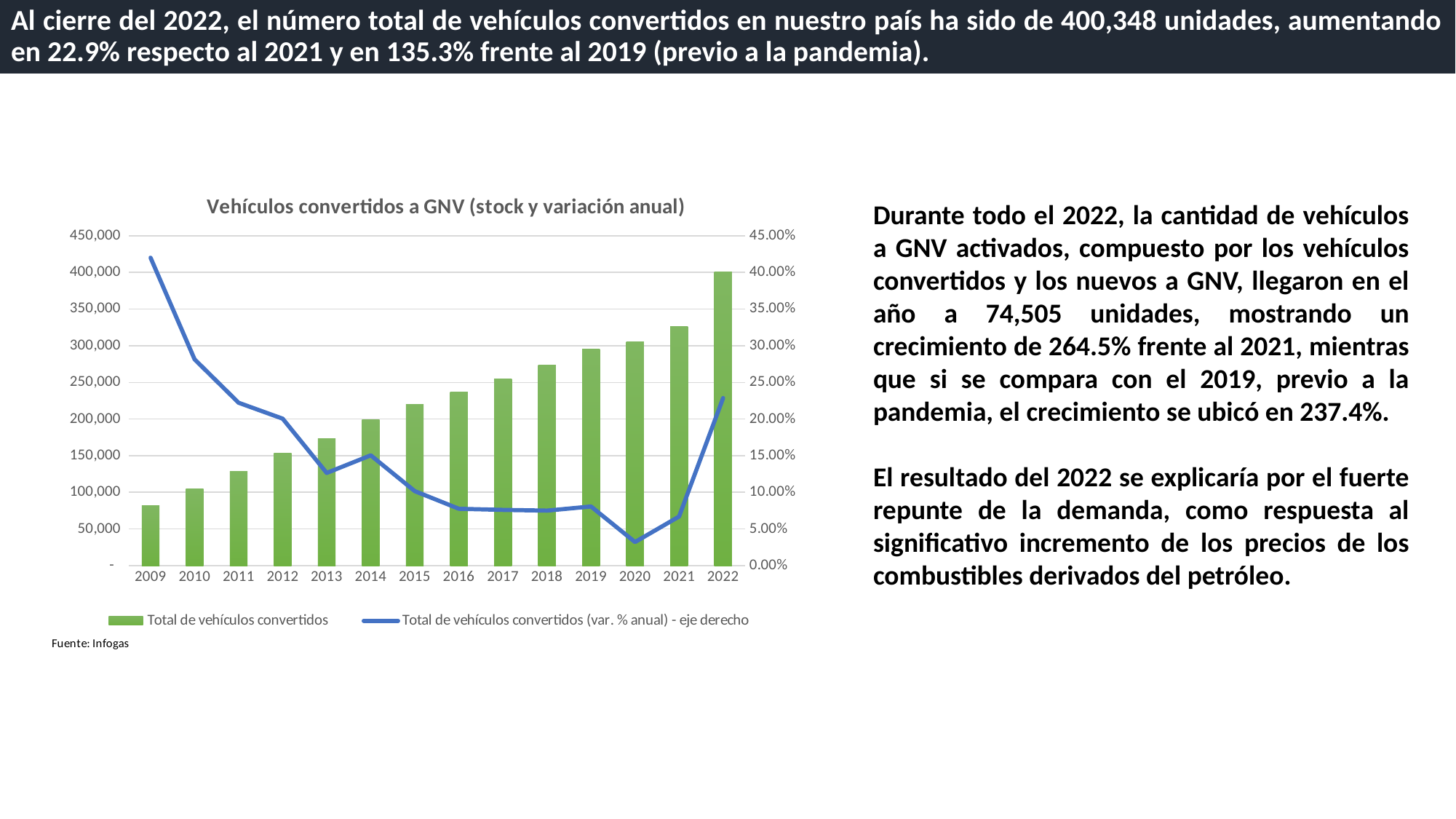
Is the bar for Total de vehículos convertidos in 2021 greater or less than 300,000? greater Is the annual variation (var. % anual) for 2020 greater or less than 5.00%? less Which year has the lowest bar for Total de vehículos convertidos? 2009 Do the bars for Total de vehículos convertidos rise or fall from 2009 to 2022? rise Which year has a larger bar for Total de vehículos convertidos, 2013 or 2018? 2018 In which year is the annual variation line (var. % anual) at its highest? 2009 What is the title of the chart? Vehículos convertidos a GNV (stock y variación anual) What kind of chart is shown on the slide? A combined bar and line chart How many series does the chart legend list? 2 Which year has the highest bar for Total de vehículos convertidos? 2022 How many years are shown on the x axis of the chart? 14 In which year is the annual variation line (var. % anual) at its lowest? 2020